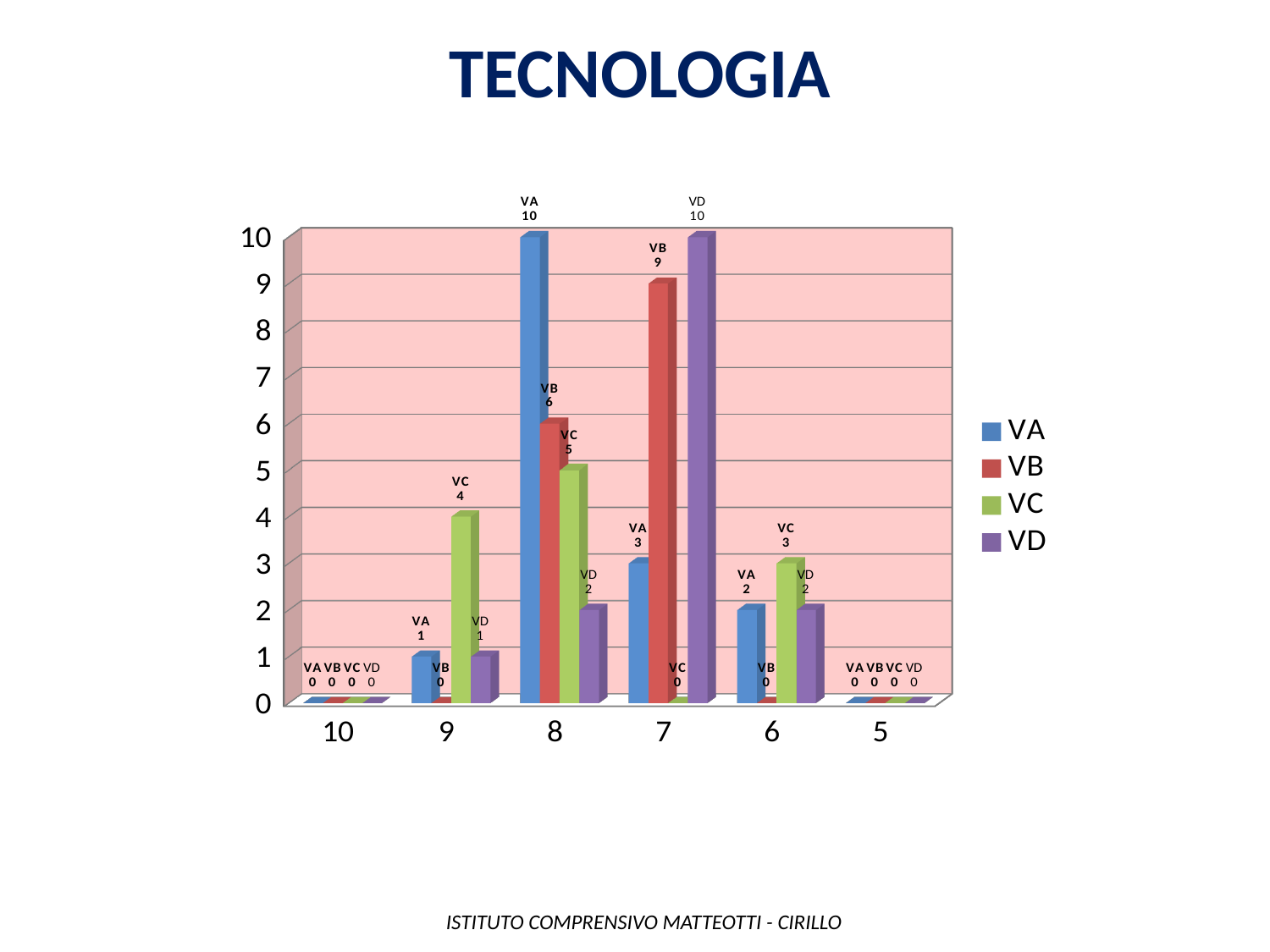
Which category has the highest value for the VD series? 7 What is the value for VB at category 7? 9 What is the value for VD at category 6? 2 What is the value for VA at category 8? 10 What kind of chart is shown on the slide? bar chart How many series does the legend list? 4 What is the title of the chart? TECNOLOGIA What is the difference between VA and VB at category 8? 4 What is the value for VC at category 9? 4 How many categories are shown on the x axis? 6 Which category has the highest value for the VC series? 8 Which is larger at category 7: VA or VB? VB